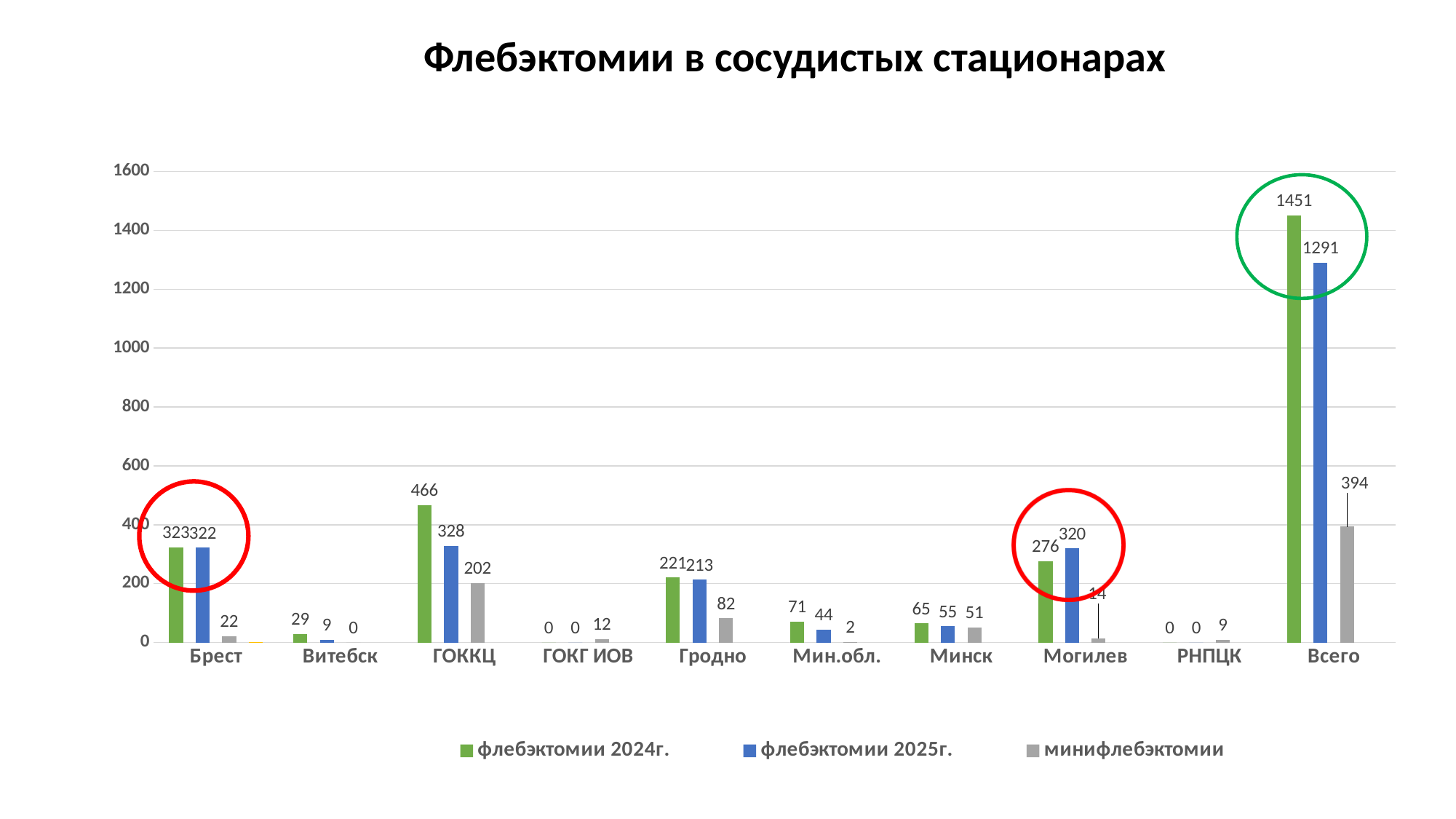
How many series does the legend list? 3 Which category has the lowest value for минифлебэктомии? Витебск How many categories are shown on the x axis? 10 What kind of chart is shown on the slide? bar chart What is the value of минифлебэктомии for Гродно? 82 What is the difference between флебэктомии 2024г. and флебэктомии 2025г. for Всего? 160 What is the value of флебэктомии 2024г. for ГОККЦ? 466 What is the value of флебэктомии 2025г. for Всего? 1291 Excluding Всего, which category has the highest value for флебэктомии 2024г.? ГОККЦ What is the value of флебэктомии 2025г. for Могилев? 320 What is the title of the chart? Флебэктомии в сосудистых стационарах For Могилев, which is larger: флебэктомии 2024г. or флебэктомии 2025г.? флебэктомии 2025г.